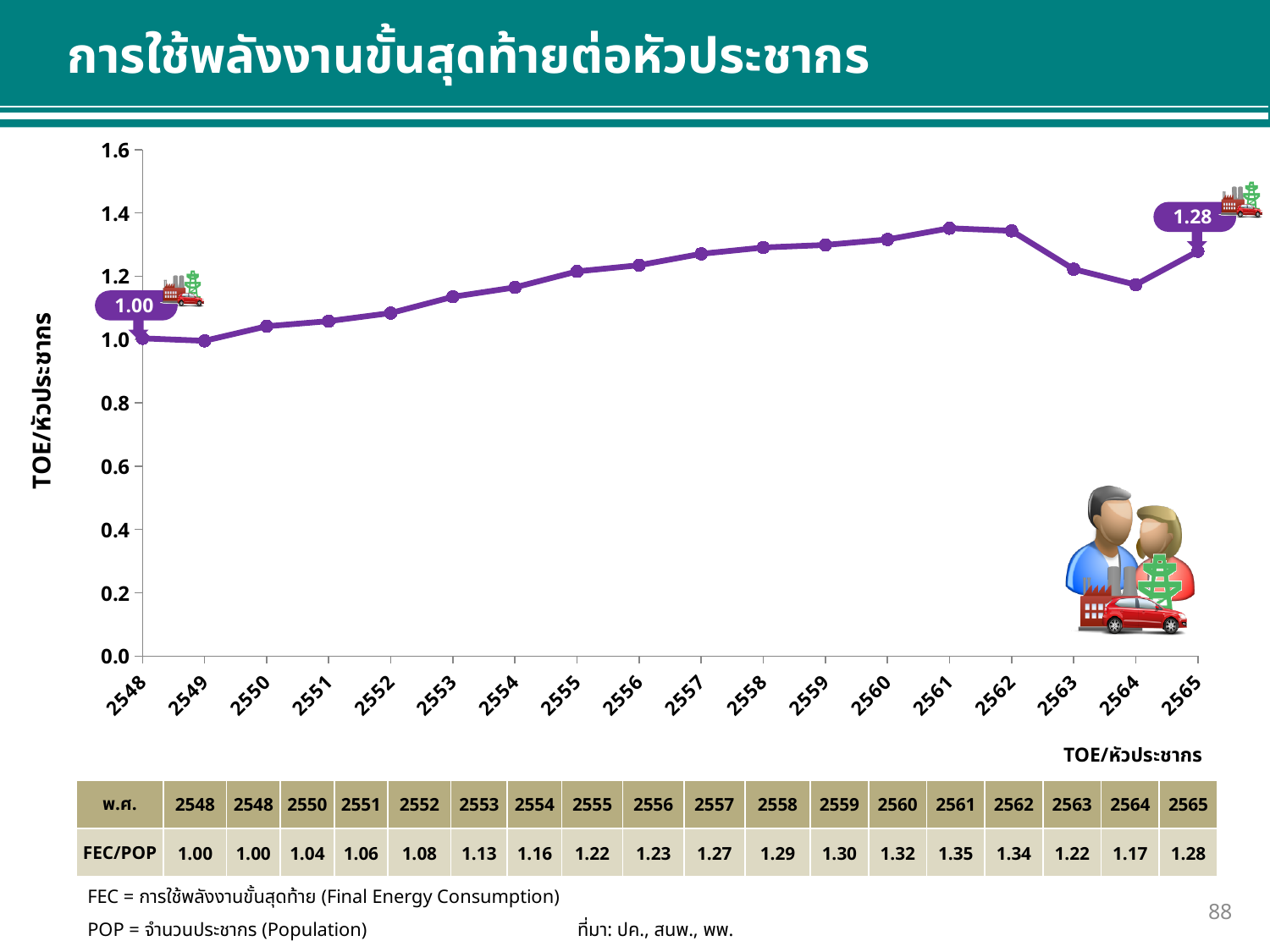
What is the lowest FEC/POP value shown? 1.00 What kind of chart is shown on the slide? line chart Do the values rise or fall from 2549 to 2561? rise What is the difference between the values for 2565 and 2548? 0.28 Which year has the larger value, 2563 or 2564? 2563 What is the FEC/POP value for 2561? 1.35 What is the value for 2548 on the chart? 1.00 How many years are plotted on the chart? 18 What is the FEC/POP value for 2564? 1.17 Is the value for 2560 greater or less than 1.2? greater Which year has the highest FEC/POP value? 2561 What is the value for 2565 on the chart? 1.28